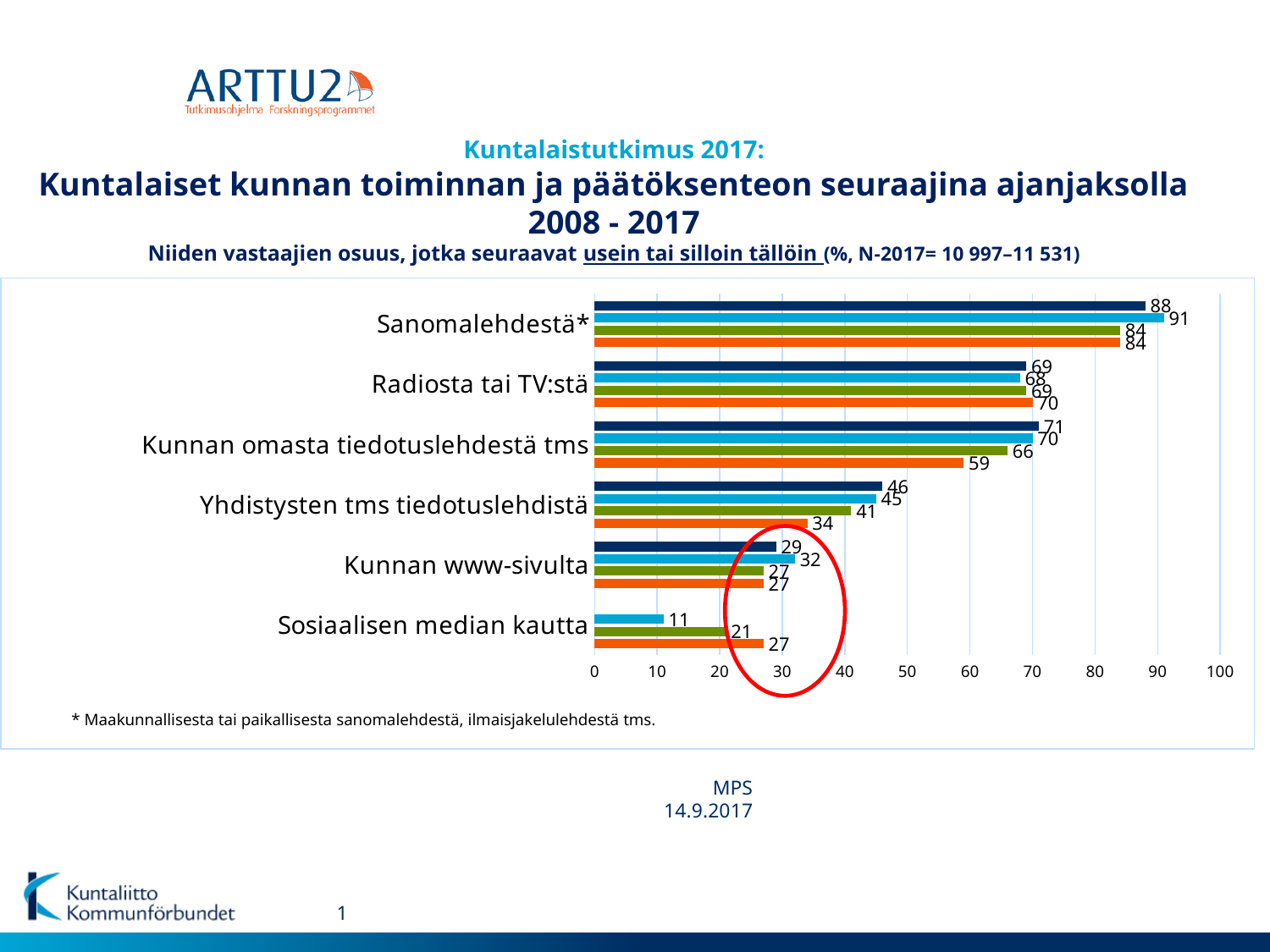
What is the value of the light blue bar for Sanomalehdestä*? 91 What is the difference between the dark blue bar (71) and the orange bar (59) for Kunnan omasta tiedotuslehdestä tms? 12 How many categories are listed on the vertical axis of the chart? 6 Is the value of the orange bar for Yhdistysten tms tiedotuslehdistä greater or less than 30? greater For Sosiaalisen median kautta, do the values rise or fall going from the light blue bar to the orange bar? rise What kind of chart is shown on the slide? bar chart For Sosiaalisen median kautta, which is larger: the light blue bar or the orange bar? the orange bar What is the value of the orange bar for Kunnan omasta tiedotuslehdestä tms? 59 What is the value of the orange bar for Sosiaalisen median kautta? 27 Which category has the lowest value in the chart? Sosiaalisen median kautta Which category has the highest value in the chart? Sanomalehdestä* How many bars are shown for the category Sosiaalisen median kautta? 3